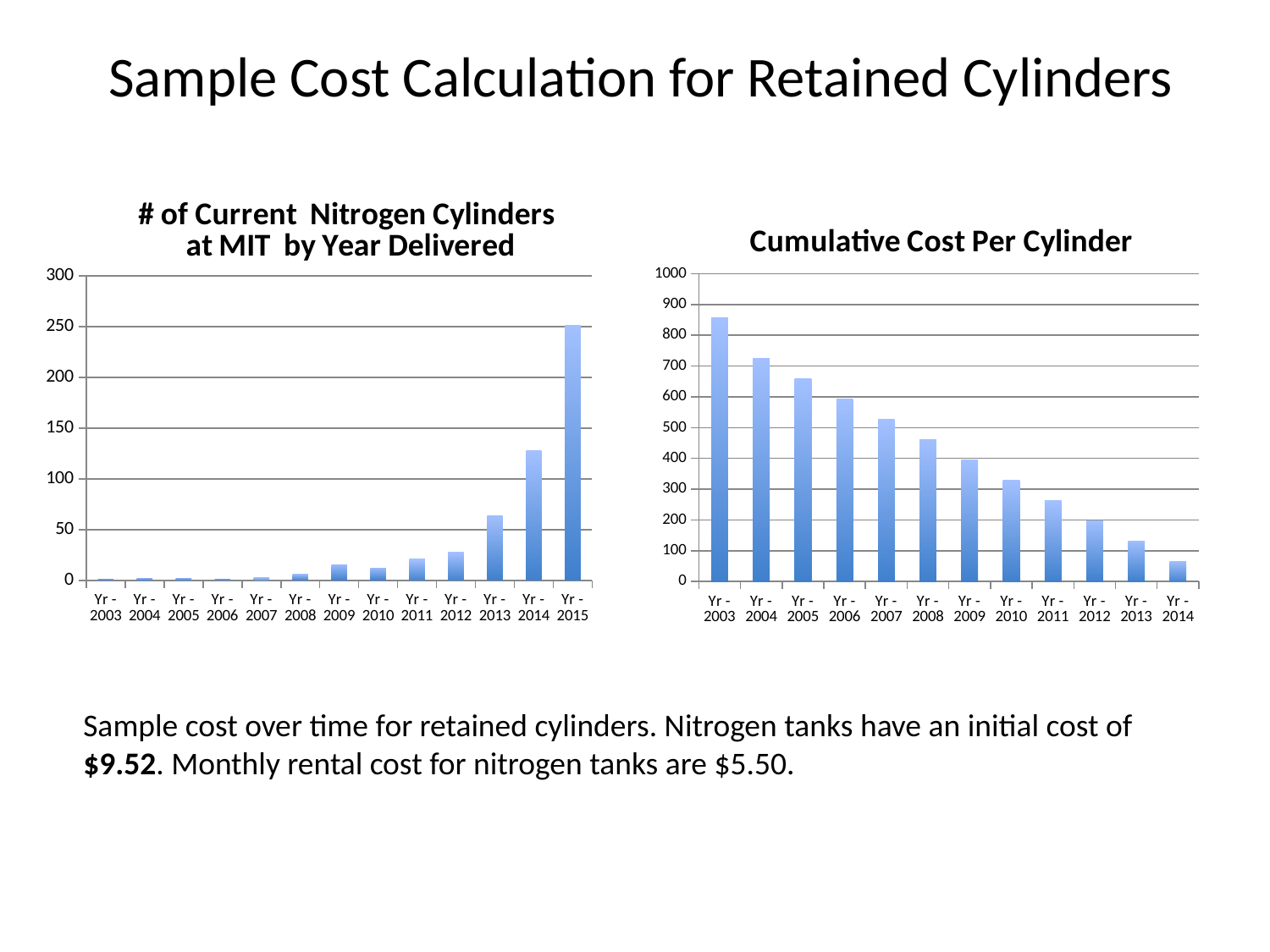
In the "Cumulative Cost Per Cylinder" chart, which year has the highest value? Yr - 2003 How many years are shown on the x axis of the "# of Current Nitrogen Cylinders at MIT by Year Delivered" chart? 13 In the "Cumulative Cost Per Cylinder" chart, is the value for Yr - 2014 greater or less than 100? less In the "# of Current Nitrogen Cylinders at MIT by Year Delivered" chart, is the value for Yr - 2012 greater or less than 50? less How many years are shown on the x axis of the "Cumulative Cost Per Cylinder" chart? 12 In the "Cumulative Cost Per Cylinder" chart, is the value for Yr - 2003 greater or less than 800? greater In the "Cumulative Cost Per Cylinder" chart, which year has the lowest value? Yr - 2014 In the "Cumulative Cost Per Cylinder" chart, do the values rise or fall from Yr - 2003 to Yr - 2014? fall What kind of chart is the "Cumulative Cost Per Cylinder" chart? bar chart In the "# of Current Nitrogen Cylinders at MIT by Year Delivered" chart, which year has the highest value? Yr - 2015 In the "Cumulative Cost Per Cylinder" chart, which is larger, the value for Yr - 2005 or Yr - 2010? Yr - 2005